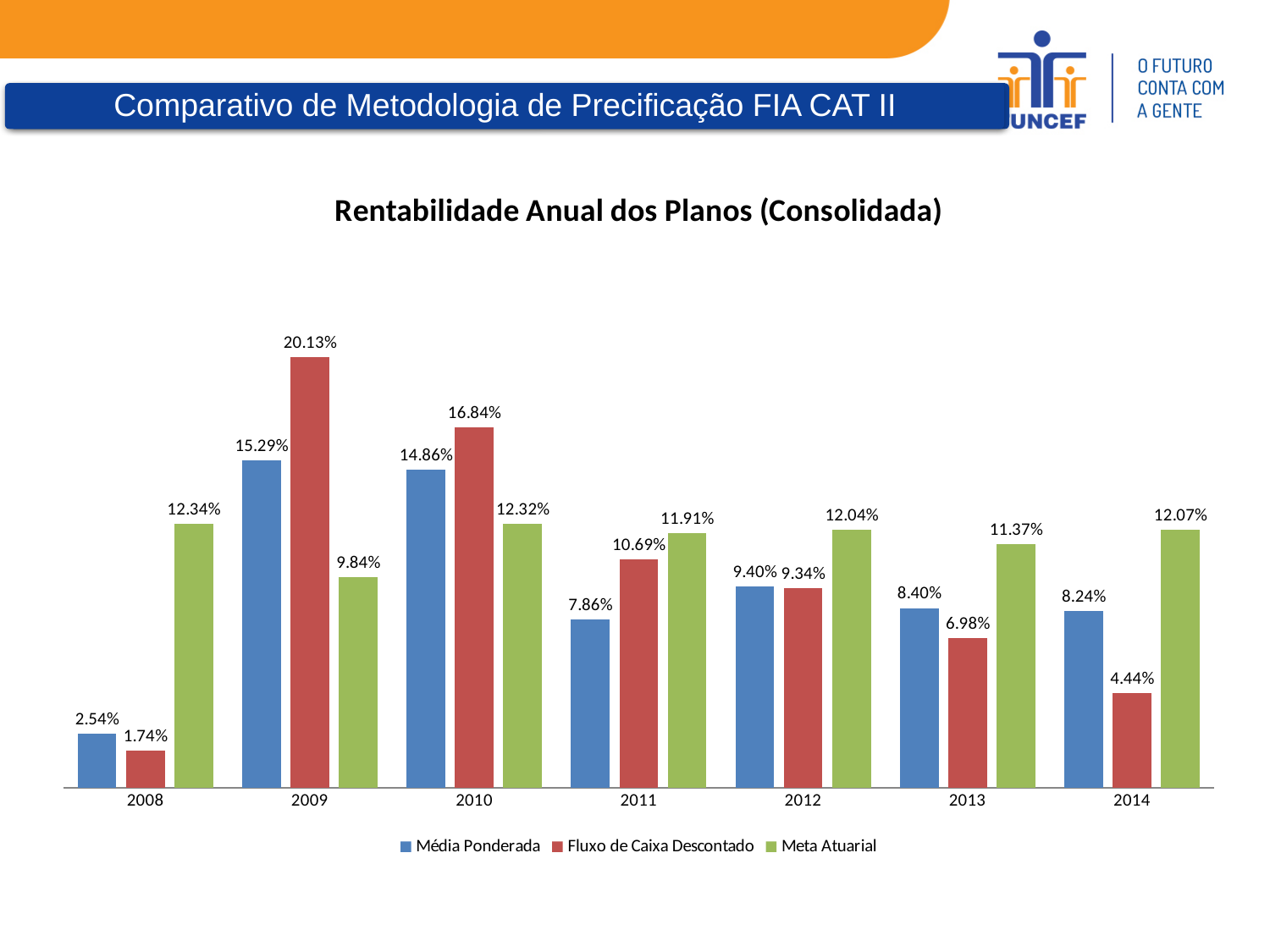
What is the title of the chart? Rentabilidade Anual dos Planos (Consolidada) In which year is Média Ponderada lowest? 2008 What is the value of Fluxo de Caixa Descontado in 2013? 6.98% How many years are shown on the x axis? 7 What is the value of Fluxo de Caixa Descontado in 2009? 20.13% What is the difference between Fluxo de Caixa Descontado and Média Ponderada in 2009? 4.84% How many series does the legend list? 3 In which year is Fluxo de Caixa Descontado highest? 2009 Which is larger in 2011, Média Ponderada or Meta Atuarial? Meta Atuarial What is the value of Média Ponderada in 2010? 14.86% What is the value of Meta Atuarial in 2014? 12.07% What kind of chart is shown on the slide? Bar chart